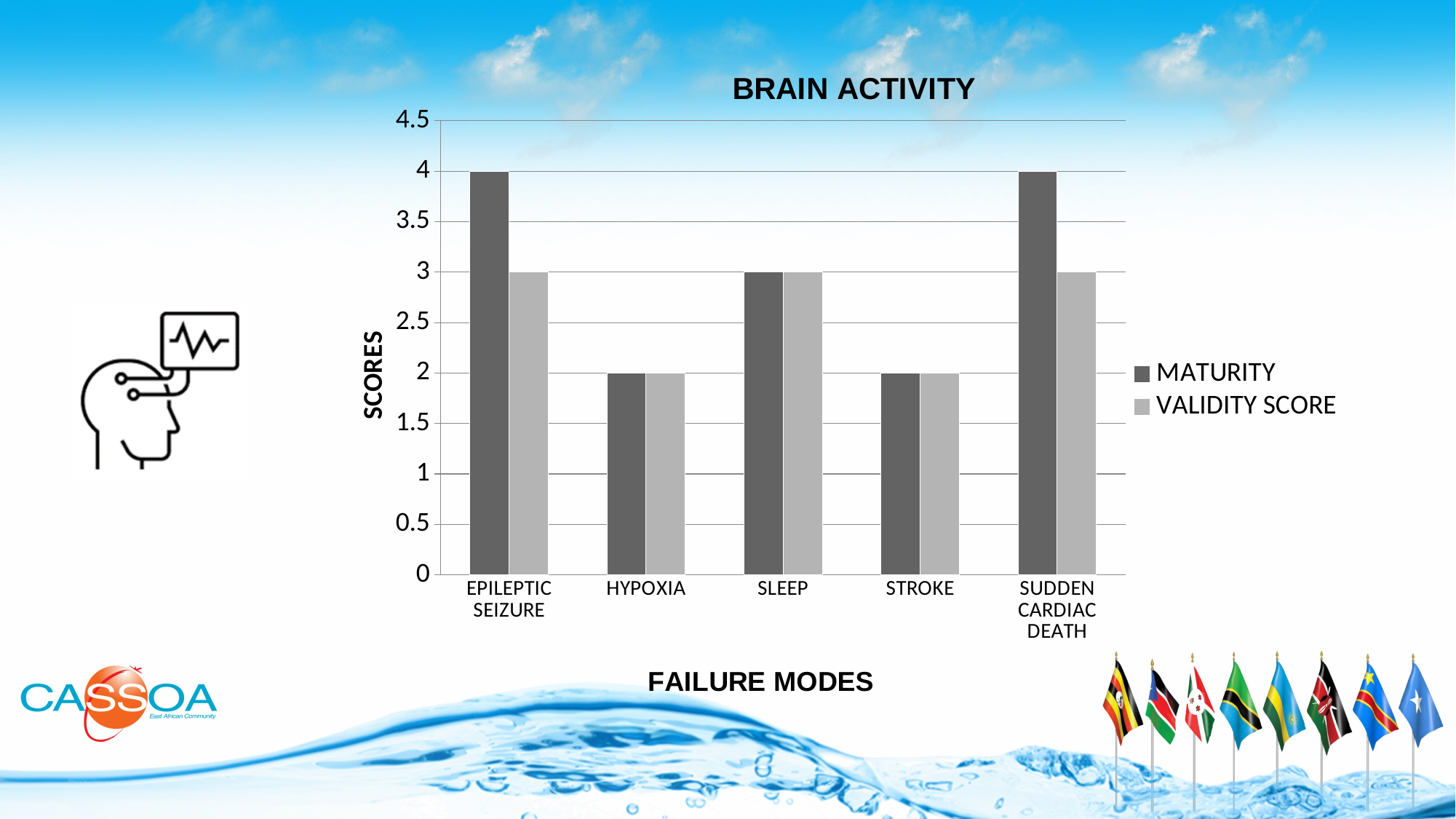
Is the MATURITY score for SUDDEN CARDIAC DEATH greater or less than 3.5? greater What is the label of the y axis? SCORES How many series does the legend list? 2 What is the VALIDITY SCORE for STROKE? 2 Which has a higher MATURITY score, EPILEPTIC SEIZURE or HYPOXIA? EPILEPTIC SEIZURE What type of chart is shown on the slide? bar chart What is the MATURITY score for SLEEP? 3 What is the title of the chart? BRAIN ACTIVITY What is the MATURITY score for EPILEPTIC SEIZURE? 4 How many failure modes are shown on the x axis? 5 What is the VALIDITY SCORE for SUDDEN CARDIAC DEATH? 3 What is the difference between the MATURITY score and the VALIDITY SCORE for EPILEPTIC SEIZURE? 1